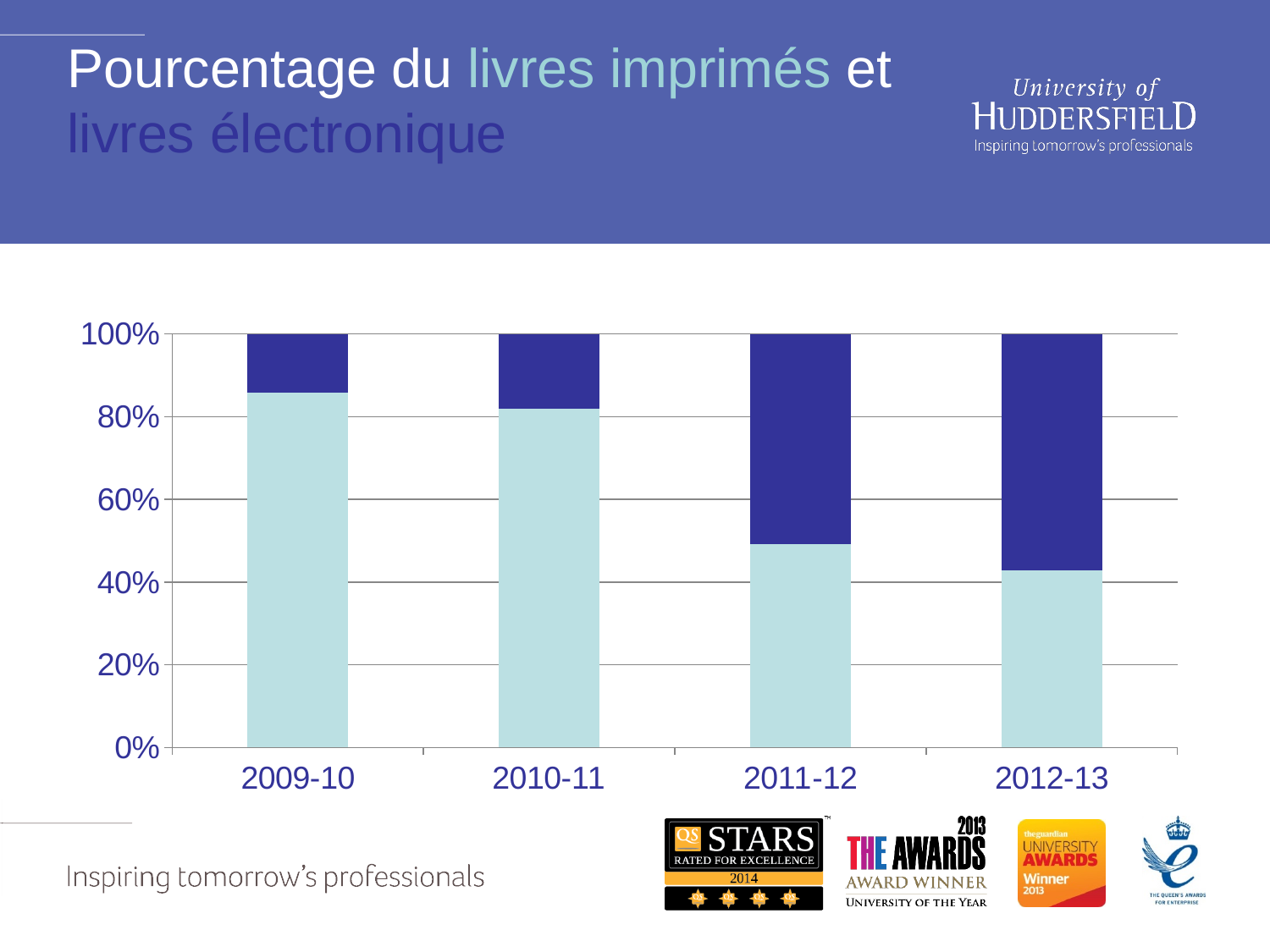
Is the light blue segment for 2009-10 greater or less than 80%? greater Is the light blue segment for 2011-12 greater or less than 60%? less In which year is the light blue segment the largest? 2009-10 How many academic years are shown on the x axis of the chart? 4 Is the light blue segment for 2012-13 greater or less than 60%? less What kind of chart is shown on the slide? stacked bar chart What is the title of the slide containing the chart? Pourcentage du livres imprimés et livres électronique Does the dark blue segment of the bars rise or fall from 2009-10 to 2012-13? rise Does the light blue segment of the bars rise or fall from 2009-10 to 2012-13? fall In which year is the light blue segment the smallest? 2012-13 What is the highest value shown on the chart's y axis? 100% Which year has a larger light blue segment, 2010-11 or 2011-12? 2010-11